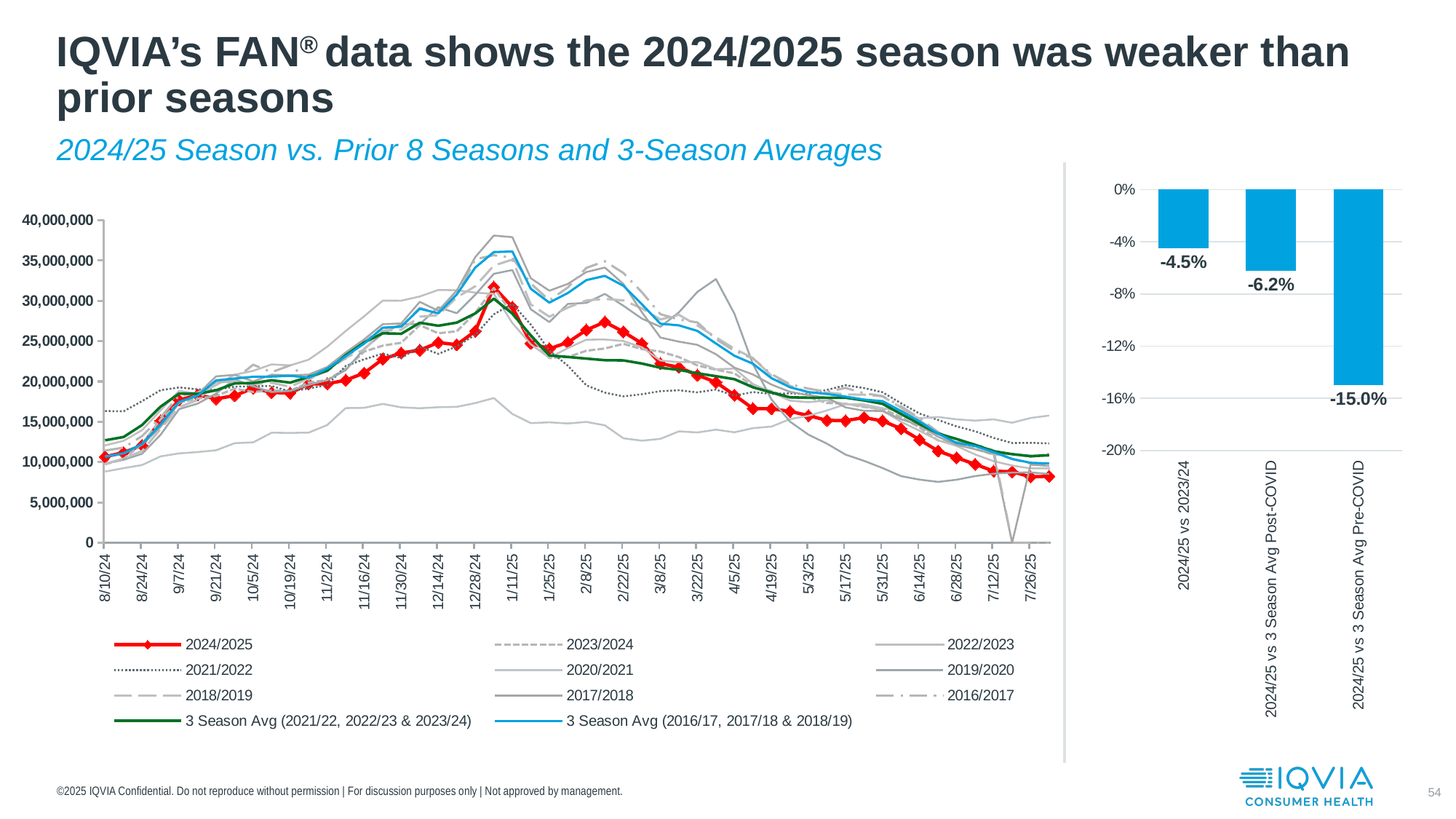
What kind of chart is on the right side of the slide? Bar chart In the bar chart on the right, what is the value for 2024/25 vs 3 Season Avg Post-COVID? -6.2% In the bar chart on the right, what is the difference between the values for 2024/25 vs 2023/24 and 2024/25 vs 3 Season Avg Pre-COVID? 10.5 percentage points In the bar chart on the right, what is the value for 2024/25 vs 3 Season Avg Pre-COVID? -15.0% In the line chart on the left, is the value for 2024/2025 at 7/26/25 greater or less than 10,000,000? less In the bar chart on the right, how many bars are shown? 3 In the line chart on the left, how many series does the legend list? 11 In the bar chart on the right, which category has the highest (least negative) value? 2024/25 vs 2023/24 In the bar chart on the right, what is the value for 2024/25 vs 2023/24? -4.5% In the bar chart on the right, which category has the lowest (most negative) value? 2024/25 vs 3 Season Avg Pre-COVID In the line chart on the left, what colour is the 2024/2025 line? Red What kind of chart is the '2024/25 Season vs. Prior 8 Seasons and 3-Season Averages' chart on the left? Line chart